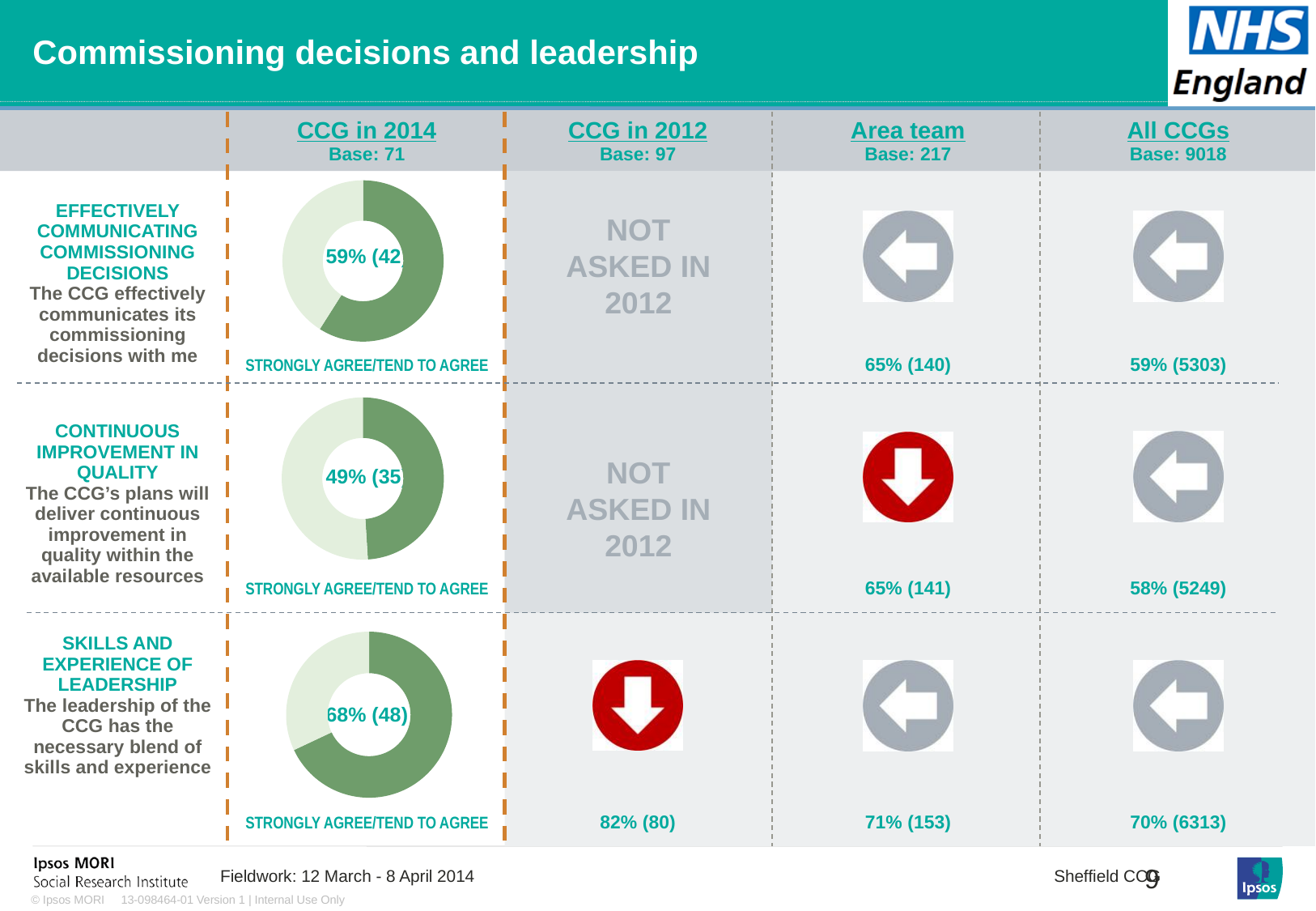
What is the base (number of respondents) for the CCG in 2014 donut charts? 71 In the 'Skills and experience of leadership' donut chart for CCG in 2014, what percentage strongly agree or tend to agree? 68% (48) What label appears beneath each of the CCG in 2014 donut charts? STRONGLY AGREE/TEND TO AGREE In the 'Continuous improvement in quality' donut chart for CCG in 2014, what percentage strongly agree or tend to agree? 49% (35) In the 'Effectively communicating commissioning decisions' donut chart for CCG in 2014, what percentage strongly agree or tend to agree? 59% (42) For 'Skills and experience of leadership', which is larger: the CCG in 2014 donut value (68%) or the CCG in 2012 value (82%)? CCG in 2012 (82%) Which of the three CCG in 2014 donut charts shows the highest percentage of strongly agree/tend to agree? Skills and experience of leadership How many donut charts are shown on the slide? 3 Is the CCG in 2014 percentage for 'Continuous improvement in quality' greater or less than 50%? less What type of chart is used in the 'CCG in 2014' column to show the proportion who strongly agree or tend to agree? Donut (pie) chart What is the difference in percentage points between the 'Skills and experience of leadership' donut (68%) and the 'Continuous improvement in quality' donut (49%) for CCG in 2014? 19 percentage points Which of the three CCG in 2014 donut charts shows the lowest percentage of strongly agree/tend to agree? Continuous improvement in quality